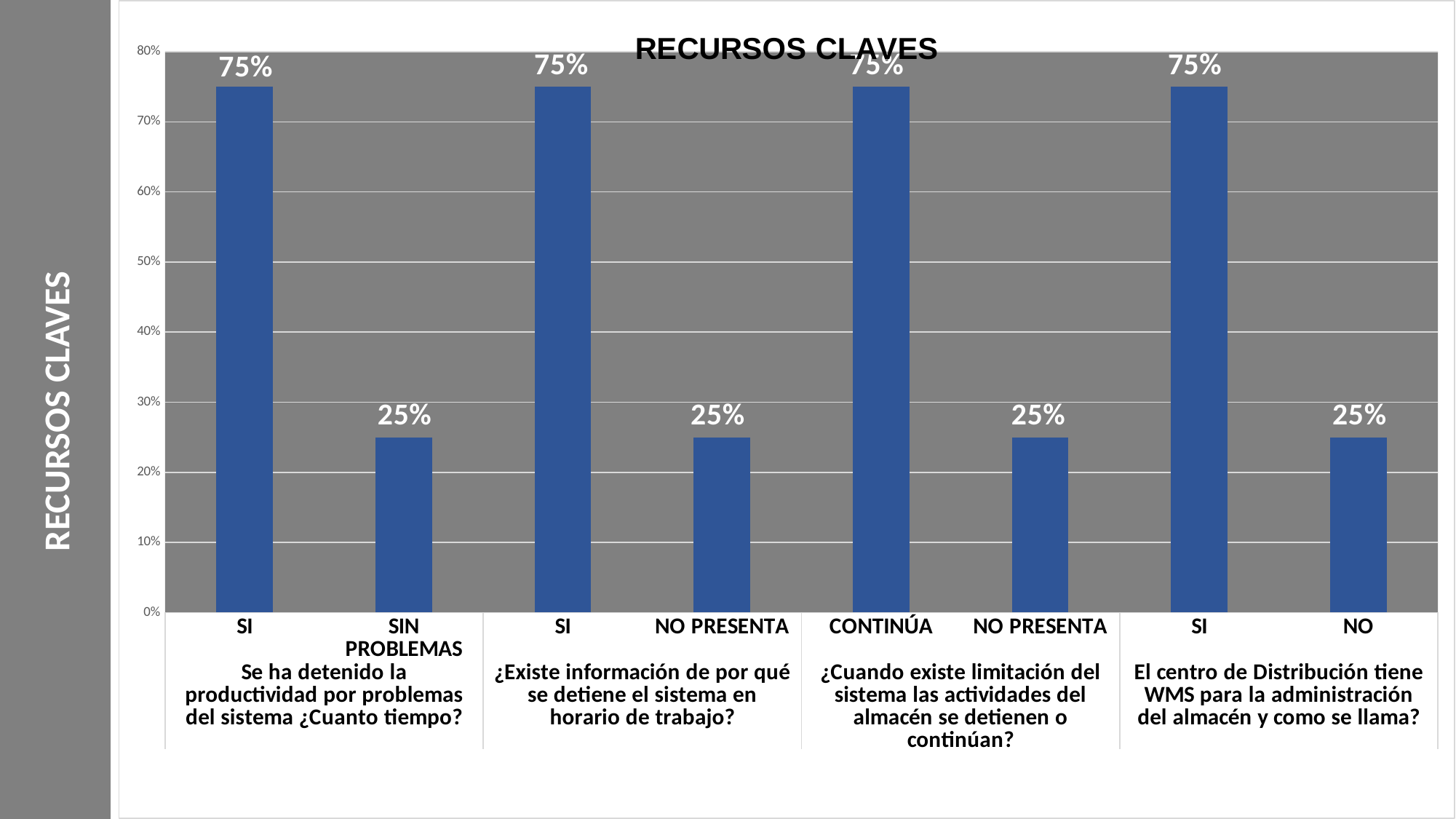
What is the difference between the "SI" and "NO" values for the question "El centro de Distribución tiene WMS para la administración del almacén y como se llama?"? 50% Which is larger for the question "¿Cuando existe limitación del sistema las actividades del almacén se detienen o continúan?": "CONTINÚA" or "NO PRESENTA"? CONTINÚA How many bars are plotted in the chart? 8 What is the total of the "SI" and "NO PRESENTA" values for the question "¿Existe información de por qué se detiene el sistema en horario de trabajo?"? 100% What type of chart is shown on the slide? bar chart What is the value for "NO PRESENTA" under the question "¿Existe información de por qué se detiene el sistema en horario de trabajo?"? 25% What is the title of the chart? RECURSOS CLAVES What is the value for "CONTINÚA" under the question "¿Cuando existe limitación del sistema las actividades del almacén se detienen o continúan?"? 75% What is the value for "NO" under the question "El centro de Distribución tiene WMS para la administración del almacén y como se llama?"? 25% What is the value for "SI" under the question "Se ha detenido la productividad por problemas del sistema ¿Cuanto tiempo?"? 75% What is the value for "SIN PROBLEMAS" under the question "Se ha detenido la productividad por problemas del sistema ¿Cuanto tiempo?"? 25% How many survey questions are shown along the x axis of the chart? 4